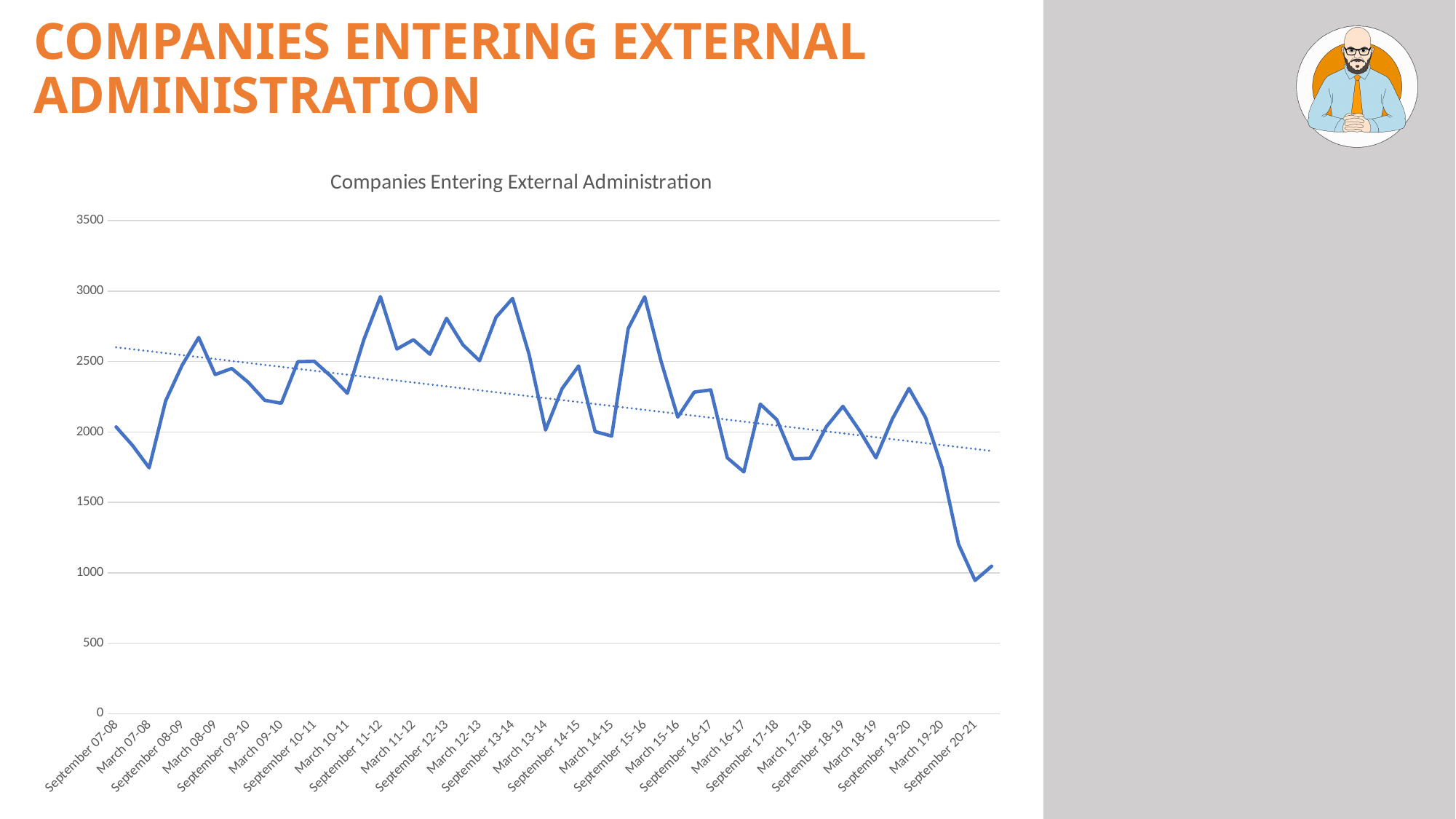
Is the value for September 20-21 greater or less than 1500? less How many labels are shown on the horizontal axis? 27 What type of chart is shown on the slide? line chart What is the highest value shown on the vertical axis? 3500 Is the value for September 07-08 greater or less than 2500? less Overall, do the values rise or fall from September 07-08 to September 20-21? fall Does the dotted trendline slope upward or downward across the chart? downward Is the highest point on the line greater or less than 3000? less What is the title of the chart? Companies Entering External Administration Which is larger, the value for September 07-08 or the value for September 20-21? September 07-08